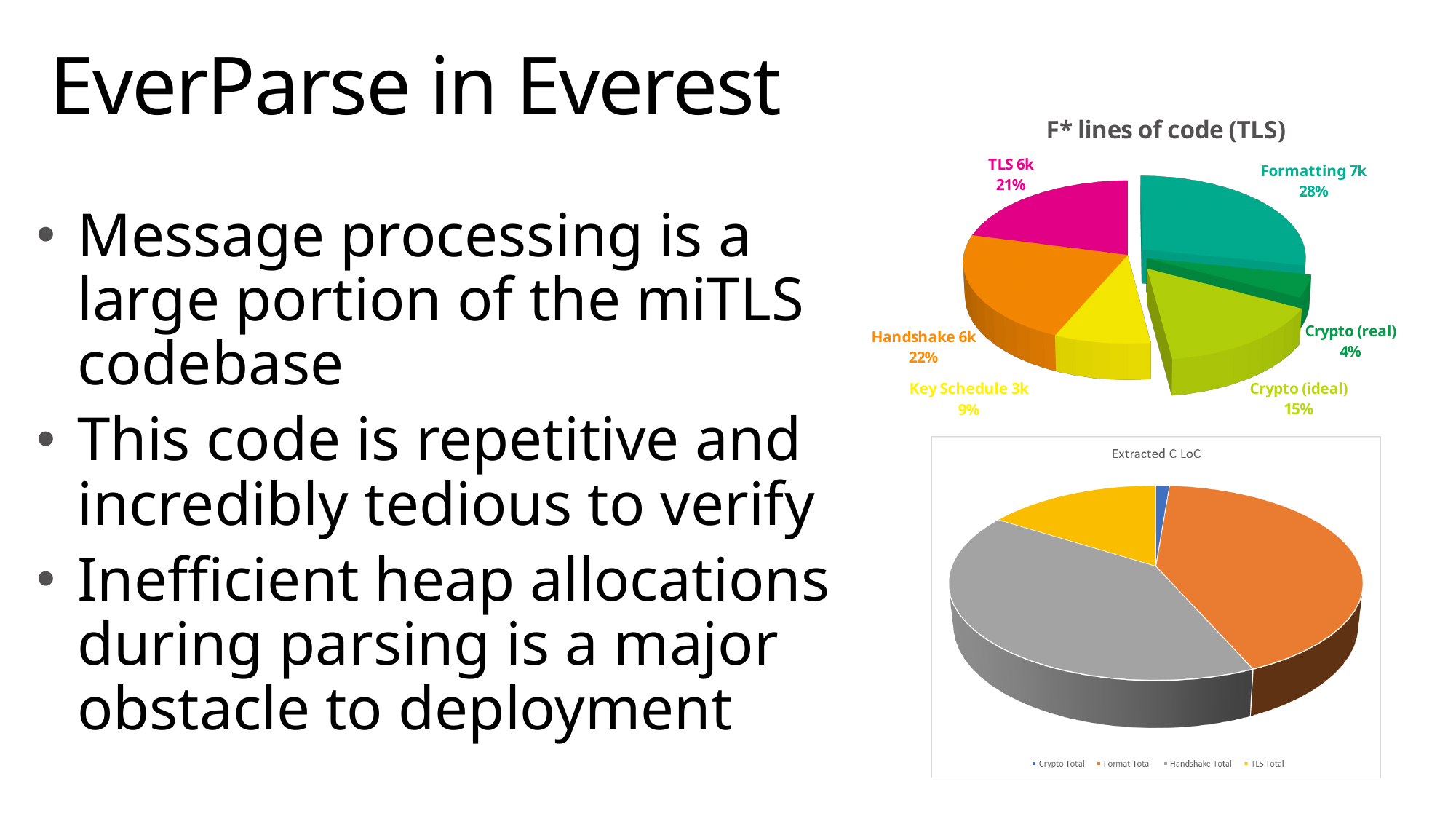
In the 'Extracted C LoC' chart, which legend entry is shown in orange? Format Total In the 'Extracted C LoC' chart, which is larger, Handshake Total or Crypto Total? Handshake Total In the 'F* lines of code (TLS)' chart, what is the difference in percentage points between Formatting and TLS? 7 In the 'F* lines of code (TLS)' chart, which is larger, Crypto (ideal) or Crypto (real)? Crypto (ideal) How many entries does the legend of the 'Extracted C LoC' chart list? 4 In the 'F* lines of code (TLS)' chart, what share of the pie does Formatting take? 28% In the 'F* lines of code (TLS)' chart, which category has the smallest share? Crypto (real) What kind of chart is the 'Extracted C LoC' chart? Pie chart In the 'F* lines of code (TLS)' chart, how many categories are shown? 6 In the 'F* lines of code (TLS)' chart, which category has the largest share? Formatting In the 'F* lines of code (TLS)' chart, what percentage is labelled for Handshake? 22% In the 'F* lines of code (TLS)' chart, how many lines of code are shown for Key Schedule? 3k